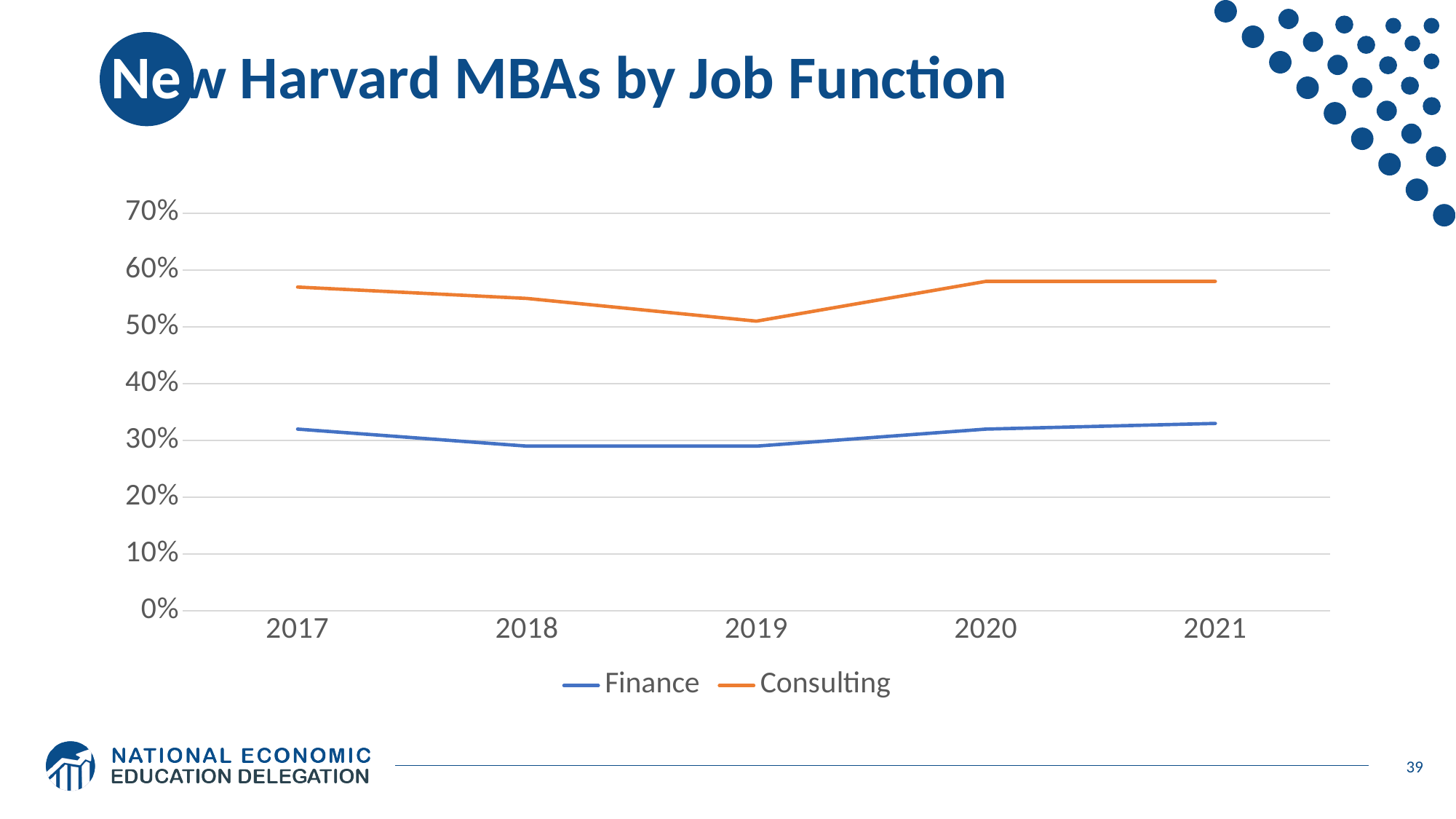
What kind of chart is shown on the slide? line chart What is the title of the chart? New Harvard MBAs by Job Function Is the Finance value for 2017 greater or less than 40%? less How many years are plotted along the x axis? 5 Is the Consulting value for 2017 greater or less than 60%? less In which year is the Consulting value lowest? 2019 How many series does the legend list? 2 Is the Consulting value for 2020 greater or less than 50%? greater Does the Finance line rise or fall from 2017 to 2018? fall In 2019, which is larger, Finance or Consulting? Consulting Does the Consulting line rise or fall from 2019 to 2020? rise Which series is plotted in orange? Consulting